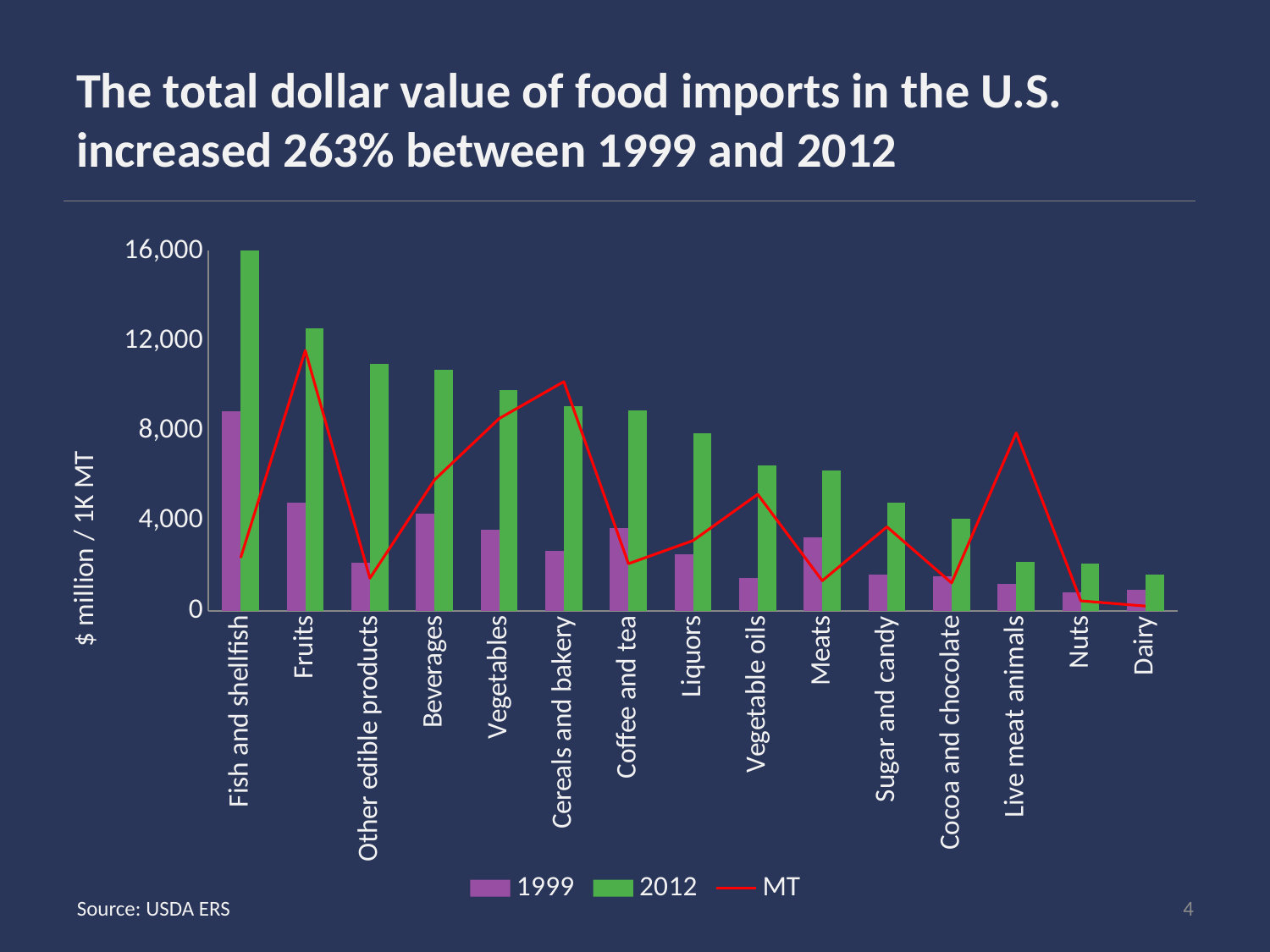
Which category has the highest 1999 value? Fish and shellfish Is the 2012 value for Fruits greater or less than 12,000? greater Do the 2012 values generally rise or fall moving from left to right along the x axis? fall Which category has the highest 2012 value? Fish and shellfish How many food categories are shown on the x axis? 15 Is the 1999 value for Beverages greater or less than 4,000? greater What is the label on the y axis? $ million / 1K MT What kind of chart is shown on the slide? bar chart with a line Is the 2012 value for Meats greater or less than 8,000? less Which category has the lowest 2012 value? Dairy Which is larger, the 2012 value for Liquors or the 2012 value for Vegetable oils? Liquors How many series does the legend list? 3